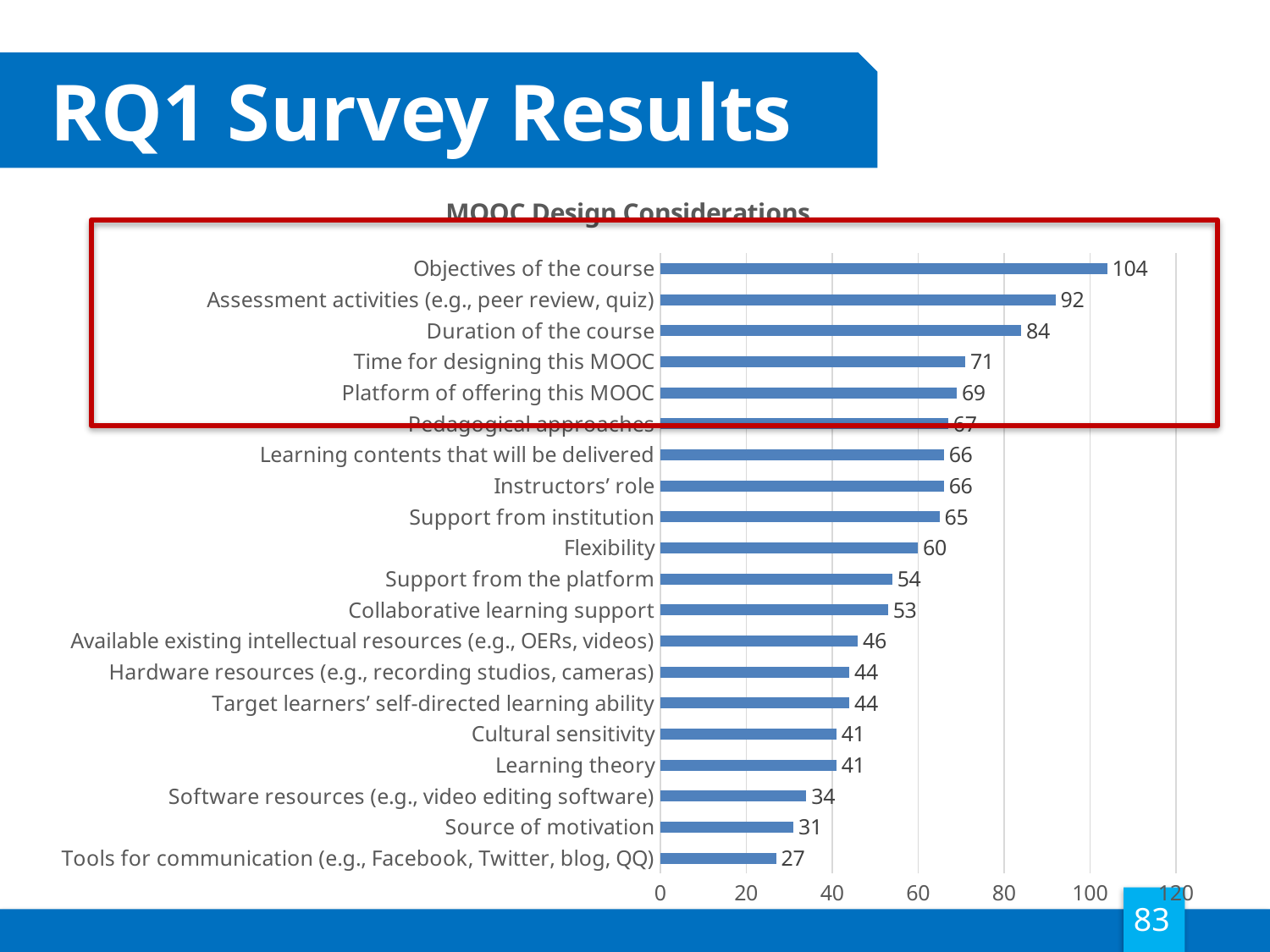
What kind of chart is shown on the slide? bar chart What value is shown for Tools for communication (e.g., Facebook, Twitter, blog, QQ)? 27 Which category has the lowest value? Tools for communication (e.g., Facebook, Twitter, blog, QQ) What value is shown for Flexibility? 60 Which is larger, the value for Support from the platform or the value for Cultural sensitivity? Support from the platform What is the difference between the values for Objectives of the course and Assessment activities (e.g., peer review, quiz)? 12 Is the value for Time for designing this MOOC greater or less than 60? greater What value is shown for Objectives of the course? 104 How many categories are plotted in the chart? 20 What is the title of the chart? MOOC Design Considerations Which category has the highest value? Objectives of the course What value is shown for Duration of the course? 84